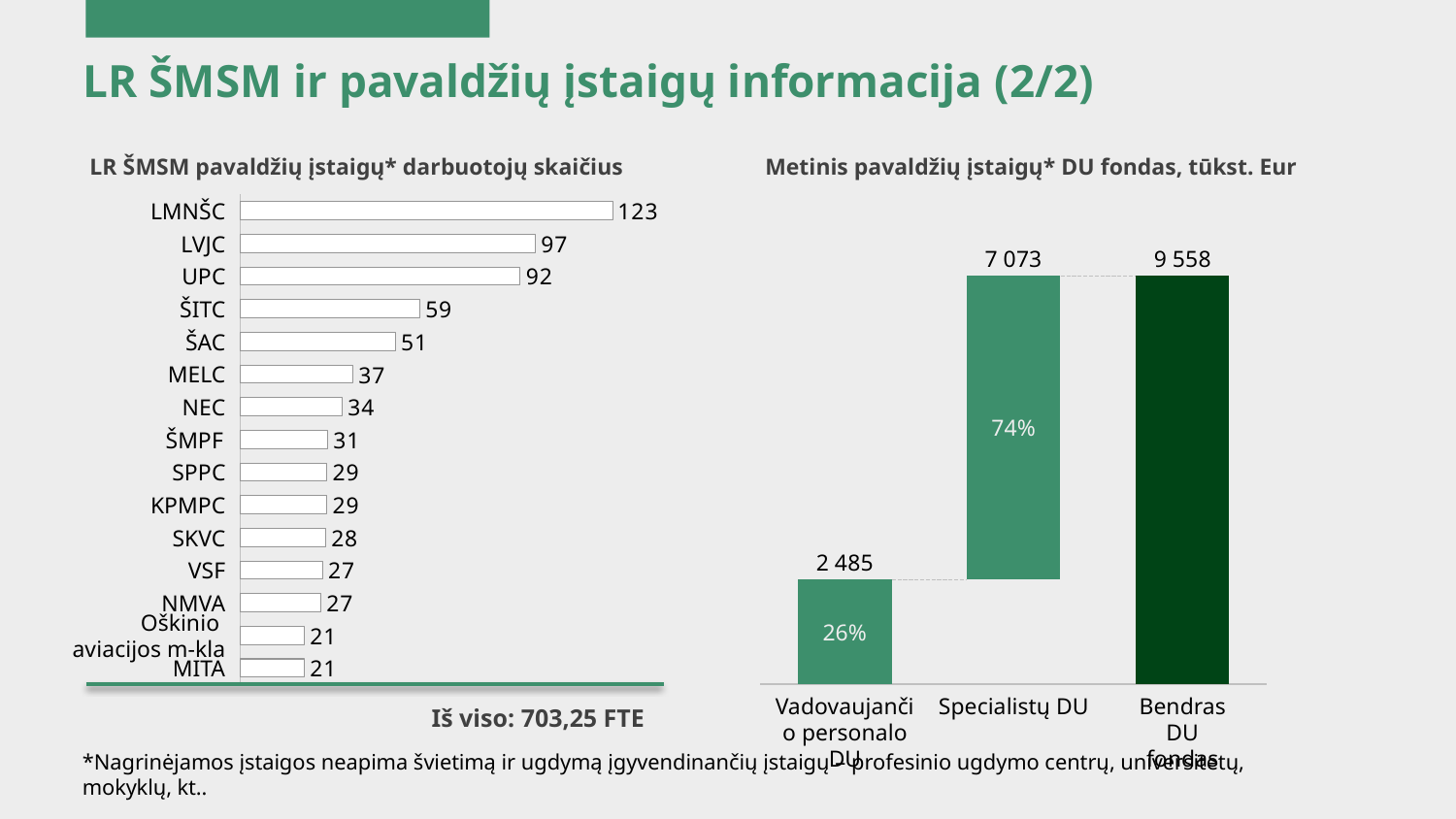
What kind of chart is 'LR ŠMSM pavaldžių įstaigų* darbuotojų skaičius'? Bar chart In the chart 'Metinis pavaldžių įstaigų* DU fondas, tūkst. Eur', what percentage is shown on the Vadovaujančio personalo DU bar? 26% In the chart 'Metinis pavaldžių įstaigų* DU fondas, tūkst. Eur', what is the value for Specialistų DU? 7 073 In the chart 'LR ŠMSM pavaldžių įstaigų* darbuotojų skaičius', what is the value for ŠITC? 59 What total is stated below the chart 'LR ŠMSM pavaldžių įstaigų* darbuotojų skaičius'? Iš viso: 703,25 FTE In the chart 'LR ŠMSM pavaldžių įstaigų* darbuotojų skaičius', what is the value for LMNŠC? 123 In the chart 'LR ŠMSM pavaldžių įstaigų* darbuotojų skaičius', which is larger, ŠAC or MELC? ŠAC In the chart 'Metinis pavaldžių įstaigų* DU fondas, tūkst. Eur', what is the value for Bendras DU fondas? 9 558 In the chart 'LR ŠMSM pavaldžių įstaigų* darbuotojų skaičius', what is the difference between LVJC and UPC? 5 In the chart 'LR ŠMSM pavaldžių įstaigų* darbuotojų skaičius', which category has the highest value? LMNŠC How many categories are shown in the chart 'LR ŠMSM pavaldžių įstaigų* darbuotojų skaičius'? 15 In the chart 'Metinis pavaldžių įstaigų* DU fondas, tūkst. Eur', what is the difference between Specialistų DU and Vadovaujančio personalo DU? 4 588